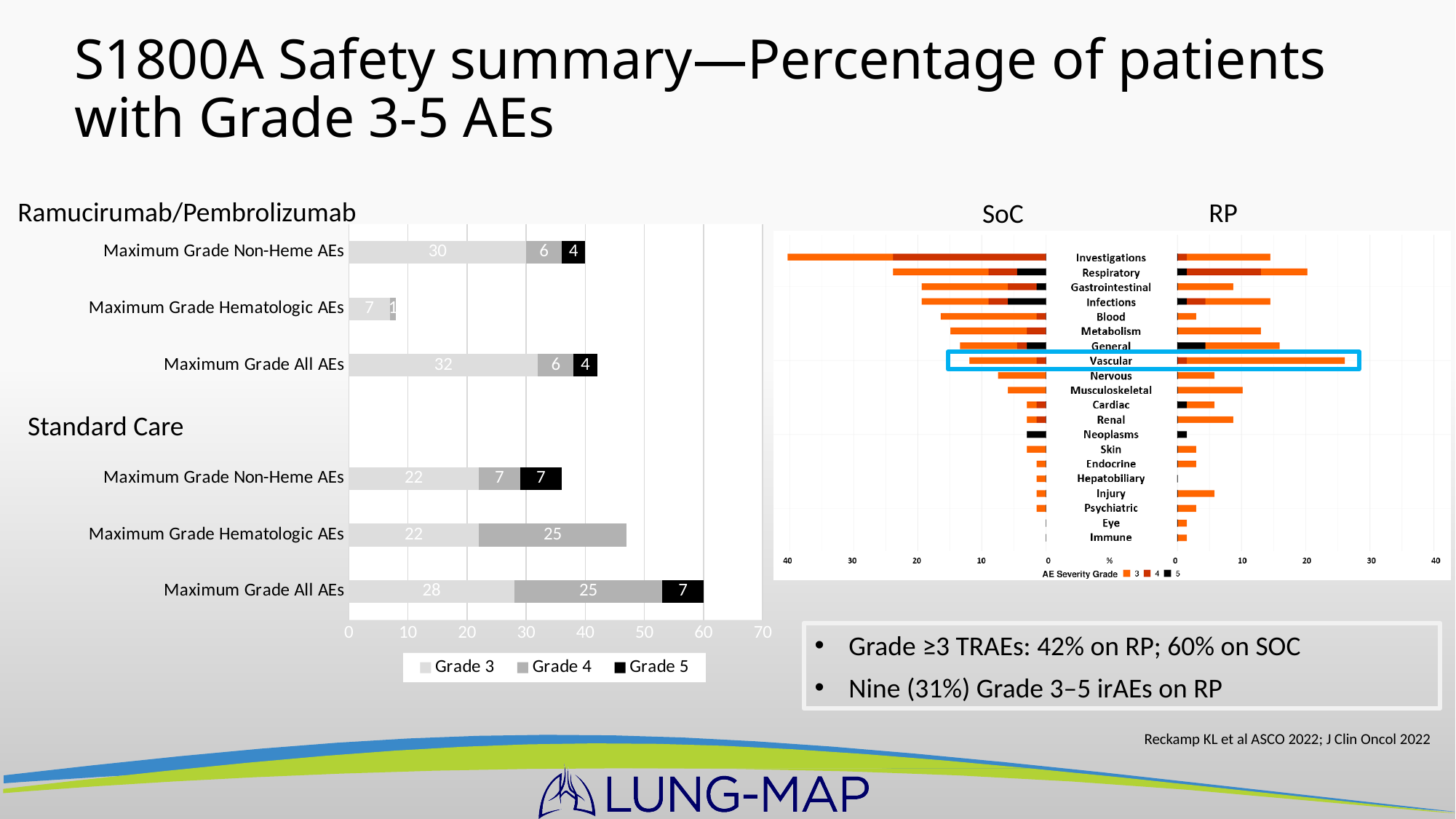
In the left chart, what is the Grade 3 value for Maximum Grade All AEs under Ramucirumab/Pembrolizumab? 32 In the left chart, what is the total of the stacked bar for Maximum Grade All AEs under Standard Care? 60 In the left chart, which bar has the smallest total? Maximum Grade Hematologic AEs (Ramucirumab/Pembrolizumab) What kind of chart is the left chart? Stacked bar chart In the left chart, what is the difference between the Grade 3 values for Maximum Grade Non-Heme AEs under Ramucirumab/Pembrolizumab and under Standard Care? 8 In the left chart, what is the total of the stacked bar for Maximum Grade All AEs under Ramucirumab/Pembrolizumab? 42 In the left chart, what is the Grade 5 value for Maximum Grade Non-Heme AEs under Standard Care? 7 In the right chart, is the total RP value for Vascular greater or less than 20? greater In the right chart, is the total SoC value for Investigations greater or less than 30? greater In the left chart, what is the Grade 4 value for Maximum Grade Hematologic AEs under Standard Care? 25 How many series does the legend of the left chart list? 3 In the left chart, which has the larger Grade 4 value: Maximum Grade Hematologic AEs under Ramucirumab/Pembrolizumab or under Standard Care? Standard Care